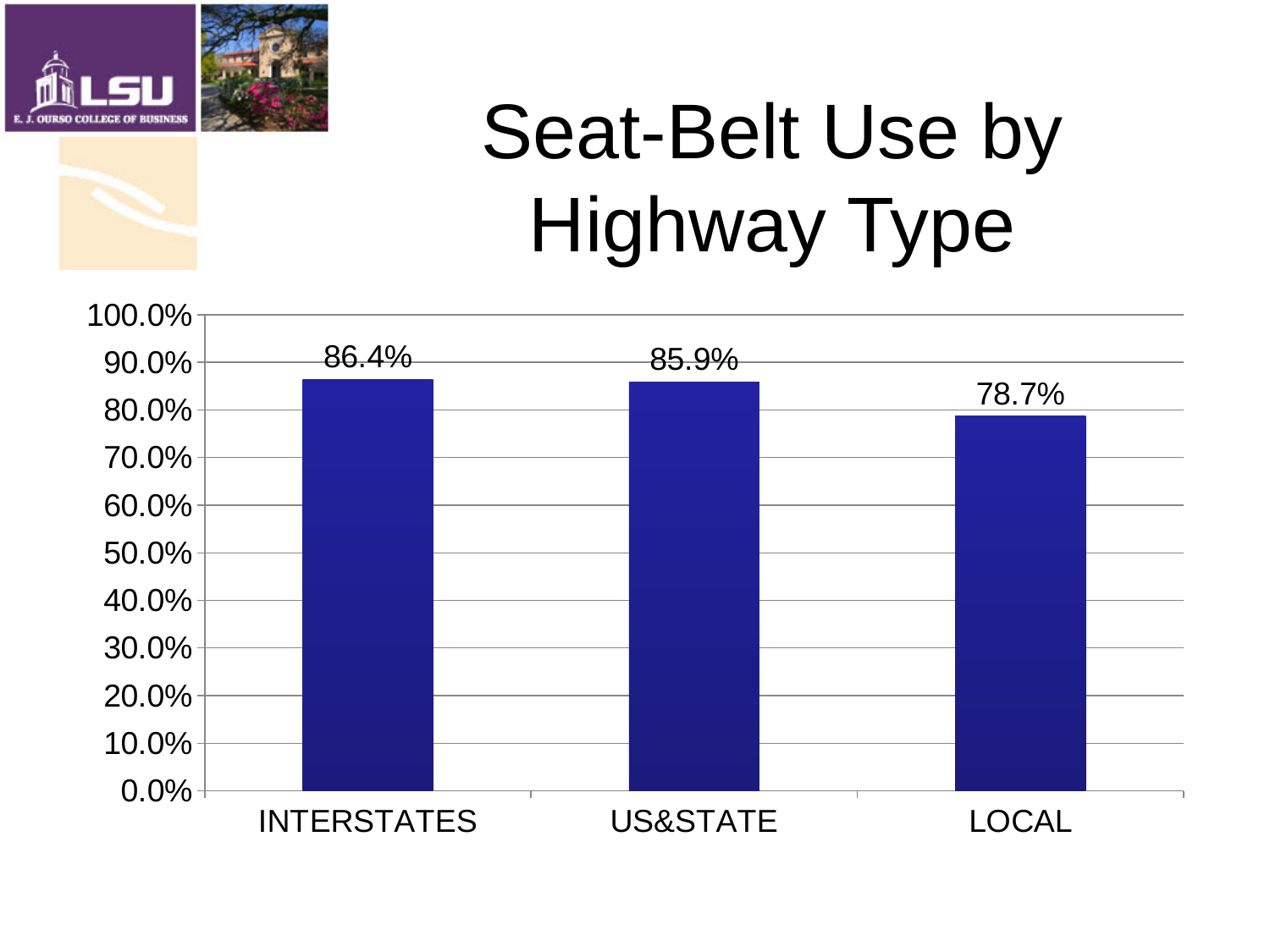
What is the difference between the seat-belt use for US&STATE and LOCAL? 7.2% Which highway type has the highest seat-belt use? INTERSTATES What is the seat-belt use value for INTERSTATES? 86.4% What is the difference between the seat-belt use for INTERSTATES and LOCAL? 7.7% Is the value for LOCAL greater or less than 80.0%? less What is the seat-belt use value for LOCAL? 78.7% What is the seat-belt use value for US&STATE? 85.9% Do the values rise or fall from left to right across the highway types? fall How many highway types are shown on the chart? 3 Which has a larger seat-belt use value, US&STATE or LOCAL? US&STATE Which highway type has the lowest seat-belt use? LOCAL What kind of chart is shown on the slide? bar chart